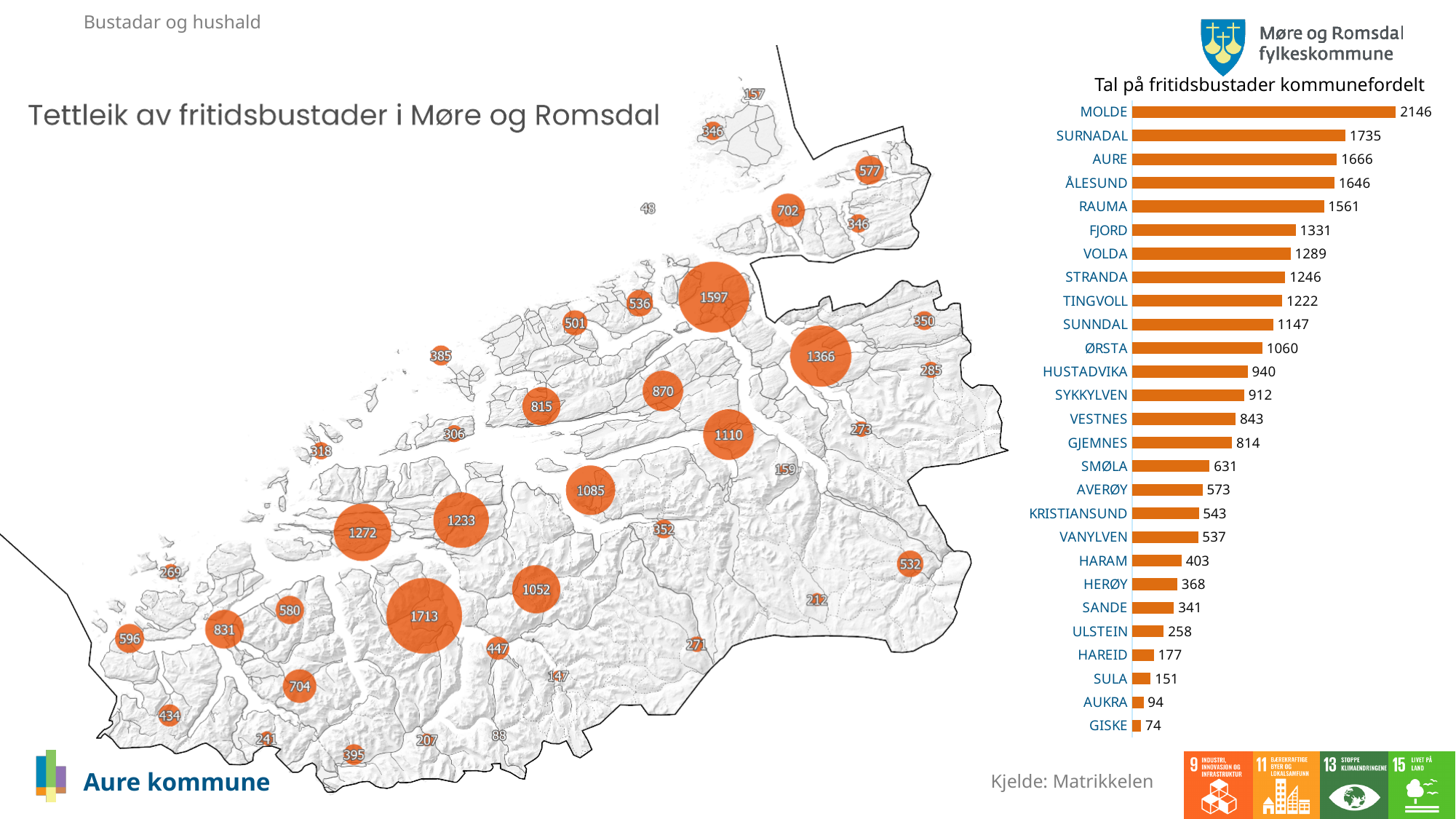
What kind of chart is 'Tal på fritidsbustader kommunefordelt'? Bar chart What is the title of the bar chart on the right side of the slide? Tal på fritidsbustader kommunefordelt In the bar chart 'Tal på fritidsbustader kommunefordelt', what is the value for MOLDE? 2146 How many municipalities are listed in the bar chart 'Tal på fritidsbustader kommunefordelt'? 27 In the bar chart 'Tal på fritidsbustader kommunefordelt', what is the difference between the values for MOLDE and SURNADAL? 411 In the bar chart 'Tal på fritidsbustader kommunefordelt', what is the value for AURE? 1666 In the bar chart 'Tal på fritidsbustader kommunefordelt', which has a larger value, HERØY or SANDE? HERØY In the bar chart 'Tal på fritidsbustader kommunefordelt', which municipality has the highest value? MOLDE In the bar chart 'Tal på fritidsbustader kommunefordelt', what is the value for SMØLA? 631 In the bar chart 'Tal på fritidsbustader kommunefordelt', which municipality has the lowest value? GISKE In the bar chart 'Tal på fritidsbustader kommunefordelt', which has a larger value, VOLDA or STRANDA? VOLDA In the bar chart 'Tal på fritidsbustader kommunefordelt', what is the difference between the values for AUKRA and GISKE? 20